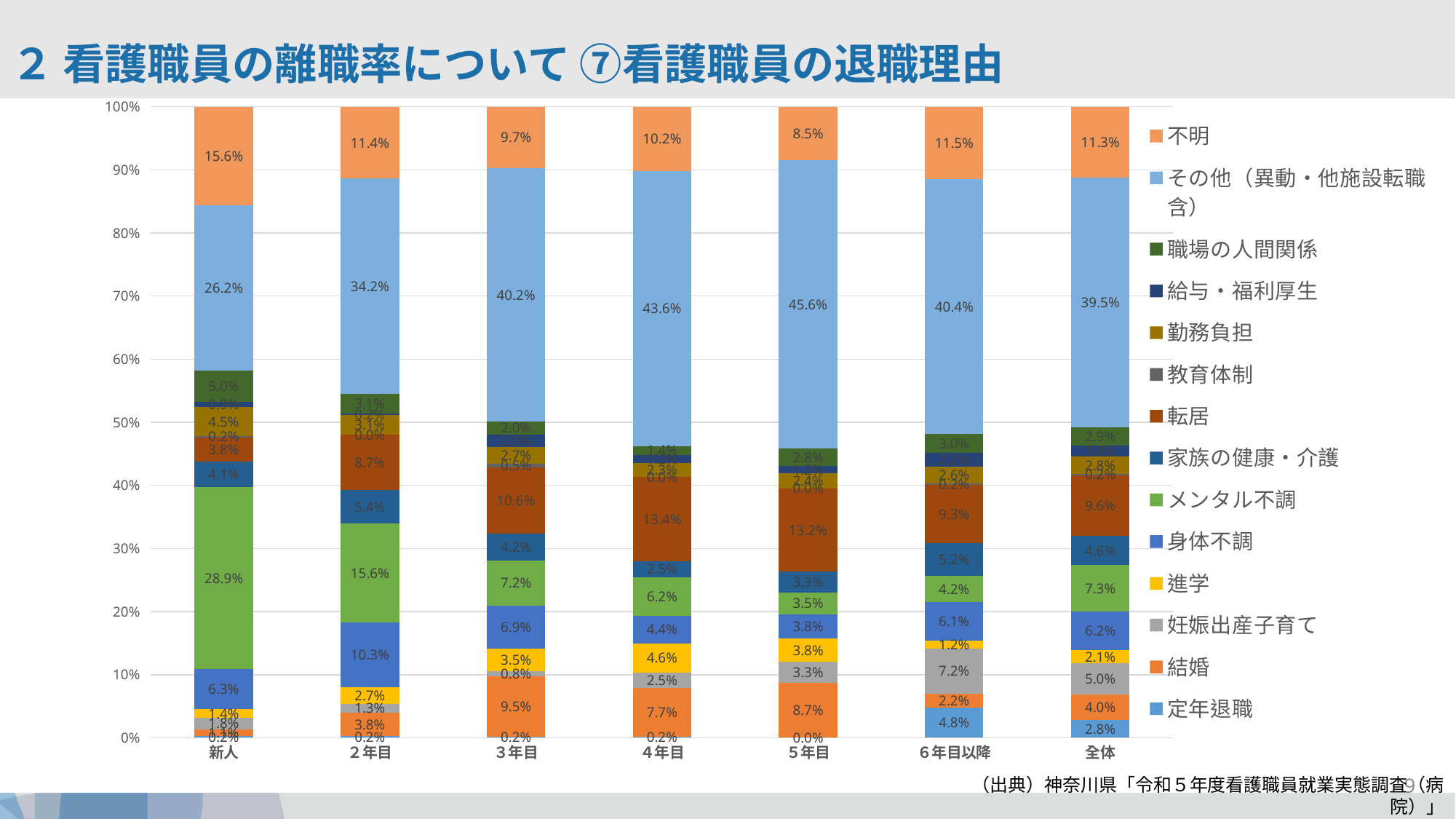
What kind of chart is shown on the slide? stacked bar chart What is the value of 定年退職 for 6年目以降? 4.8% How many series does the legend list? 14 What is the difference between the メンタル不調 values for 新人 and 2年目? 13.3% What is the value of 転居 for 4年目? 13.4% What is the value of メンタル不調 for 新人? 28.9% What is the value of その他（異動・他施設転職含） for 5年目? 45.6% Which is larger, the 身体不調 value for 2年目 or for 3年目? 2年目 Which category has the highest value for 不明? 新人 How many categories are shown along the x axis? 7 Which series is shown at the top of each bar, in orange? 不明 Which category has the lowest value for その他（異動・他施設転職含）? 新人